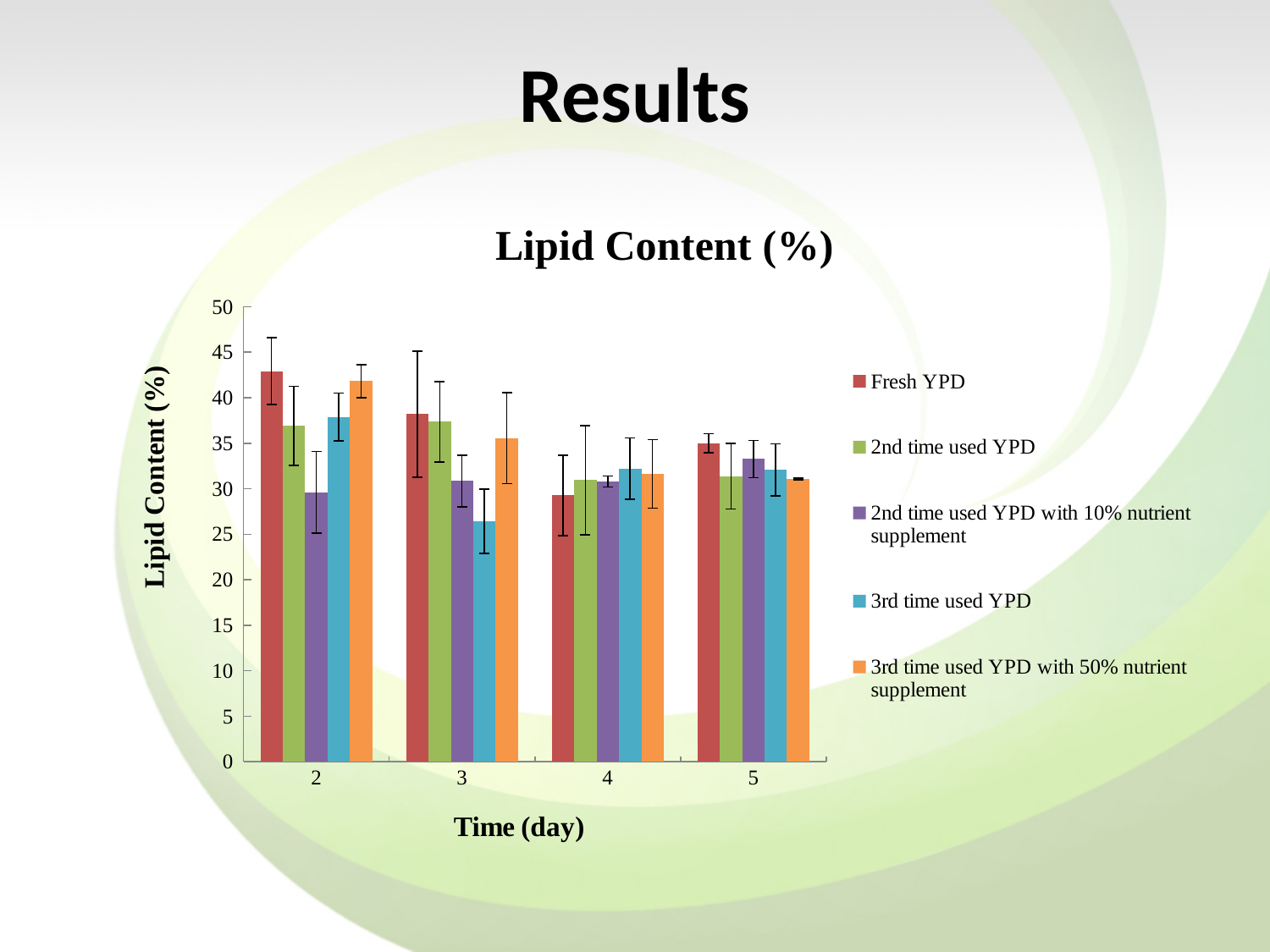
At day 3, which series has the lowest lipid content? 3rd time used YPD Does the lipid content for Fresh YPD rise or fall from day 2 to day 4? fall What is the title of the x axis? Time (day) How many time points (days) are shown on the x axis? 4 Is the value for 3rd time used YPD at day 3 greater or less than 30? less How many series does the legend list? 5 At day 2, which series has the lowest lipid content? 2nd time used YPD with 10% nutrient supplement What kind of chart is shown on the slide? bar chart Is the value for 2nd time used YPD with 10% nutrient supplement at day 2 greater or less than 35? less At day 3, which is larger: Fresh YPD or 3rd time used YPD? Fresh YPD At day 2, which is larger: Fresh YPD or 2nd time used YPD? Fresh YPD Is the value for Fresh YPD at day 2 greater or less than 40? greater